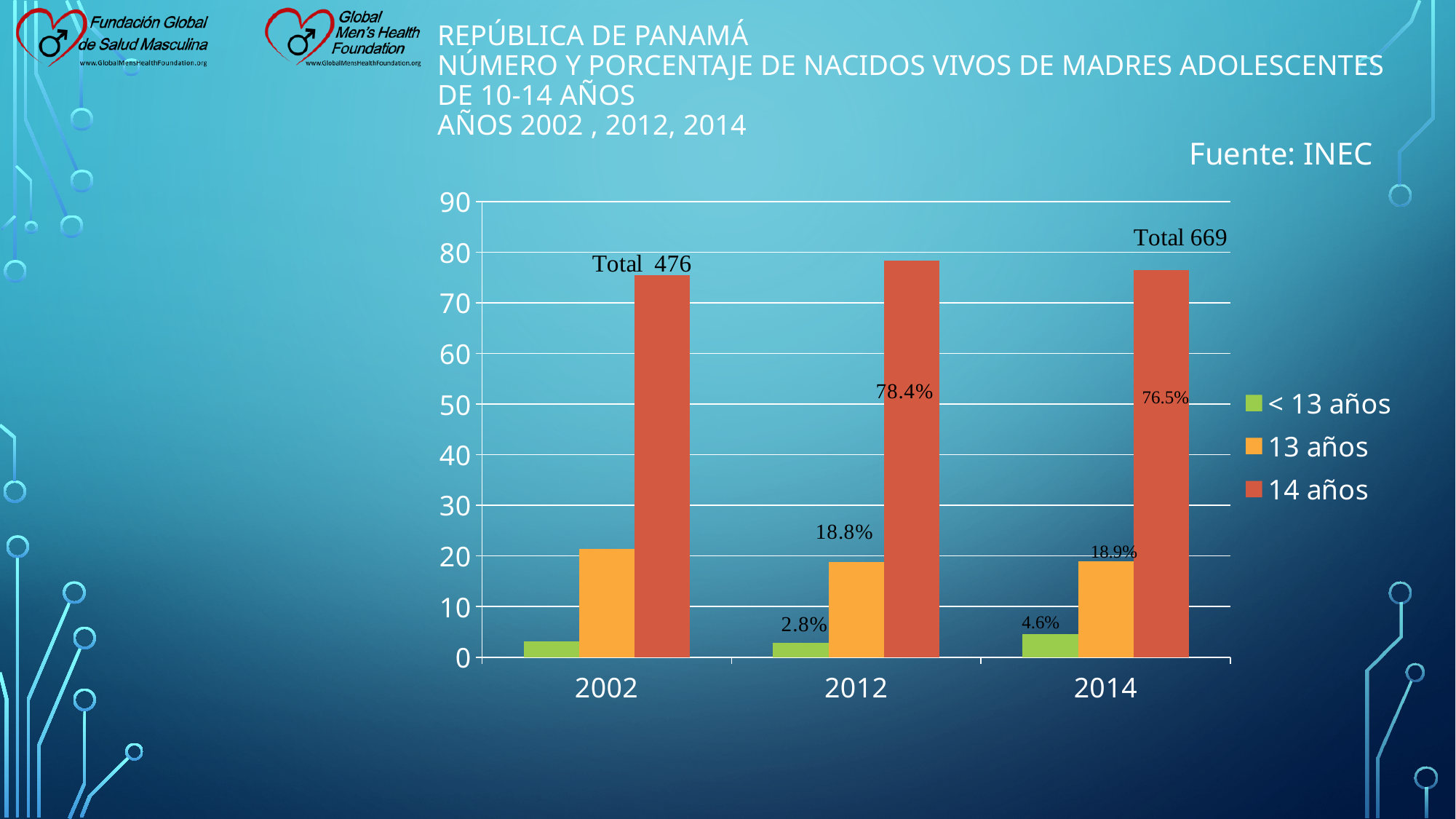
What kind of chart is shown on the slide? bar chart Which year has the larger value for 14 años, 2012 or 2014? 2012 What is the value for 14 años in 2014? 76.5% What is the value for 13 años in 2014? 18.9% How many years are shown on the x axis? 3 What is the value for < 13 años in 2012? 2.8% Is the value for 14 años in 2002 greater or less than 70? greater How many series does the legend list? 3 What is the value for 13 años in 2012? 18.8% What is the value for 14 años in 2012? 78.4% What is the difference between the 14 años values for 2012 and 2014? 1.9% What is the value for < 13 años in 2014? 4.6%